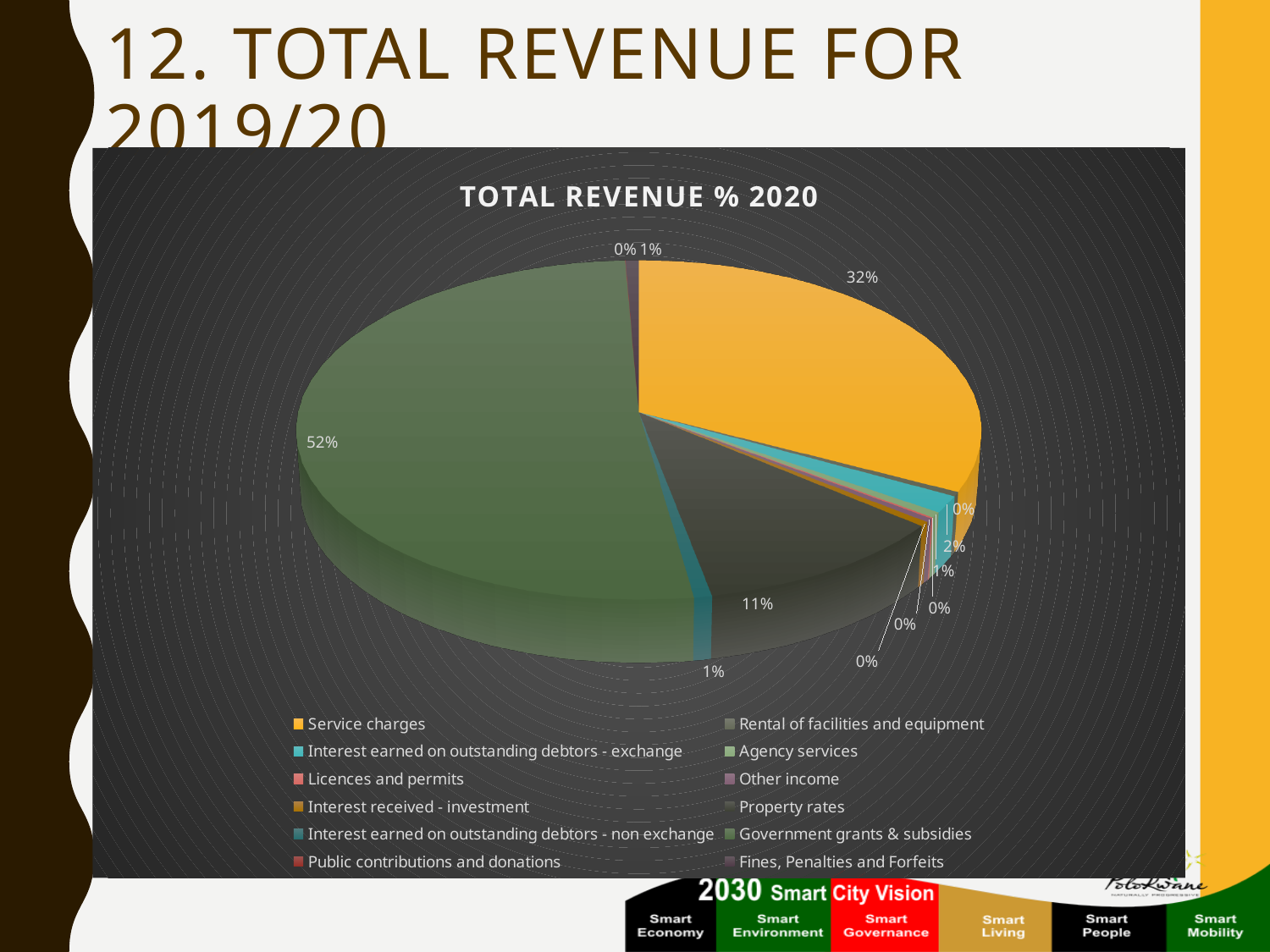
What is the title of the chart? TOTAL REVENUE % 2020 What is the difference in percentage points between the Service charges share and the Property rates share? 21 What share of total revenue comes from Service charges? 32% Is the share for Government grants & subsidies greater or less than 50%? greater What share of total revenue comes from Government grants & subsidies? 52% What share of total revenue comes from Property rates? 11% Which is larger, the share for Service charges or the share for Property rates? Service charges Which category has the largest share of total revenue? Government grants & subsidies Which legend entry is shown in orange? Service charges What kind of chart is shown on the slide? pie chart How many categories does the chart's legend list? 12 What is the difference in percentage points between the Government grants & subsidies share and the Service charges share? 20